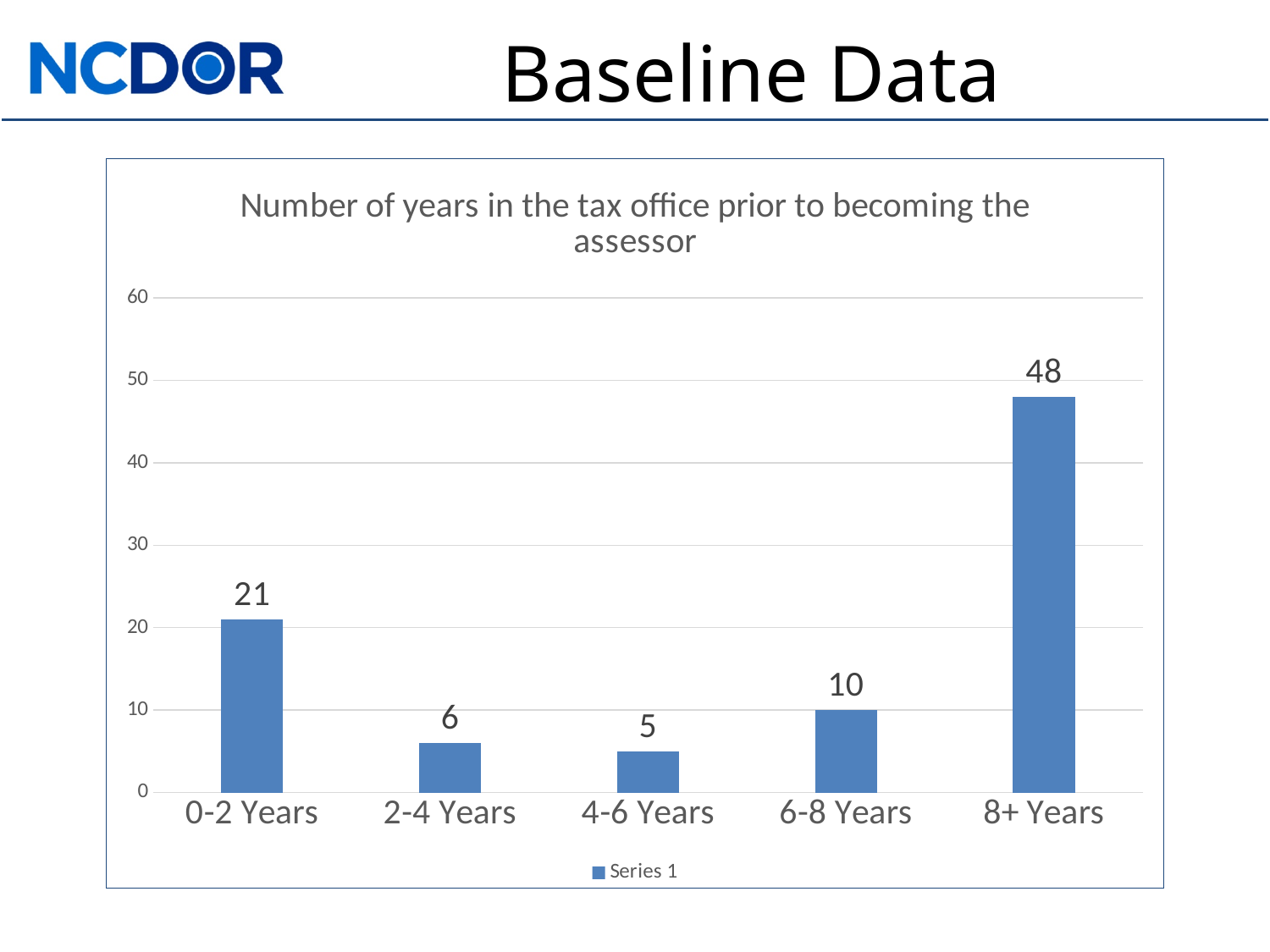
How many categories are shown on the x axis? 5 Which is larger, the value for 2-4 Years or the value for 6-8 Years? 6-8 Years What kind of chart is shown? bar chart What is the value for 6-8 Years? 10 What is the difference between the values for 8+ Years and 0-2 Years? 27 What is the value for 8+ Years? 48 How many series does the legend list? 1 Which category has the highest value? 8+ Years What is the title of the chart? Number of years in the tax office prior to becoming the assessor Is the value for 8+ Years greater or less than 40? greater Which category has the lowest value? 4-6 Years What is the value for 0-2 Years? 21